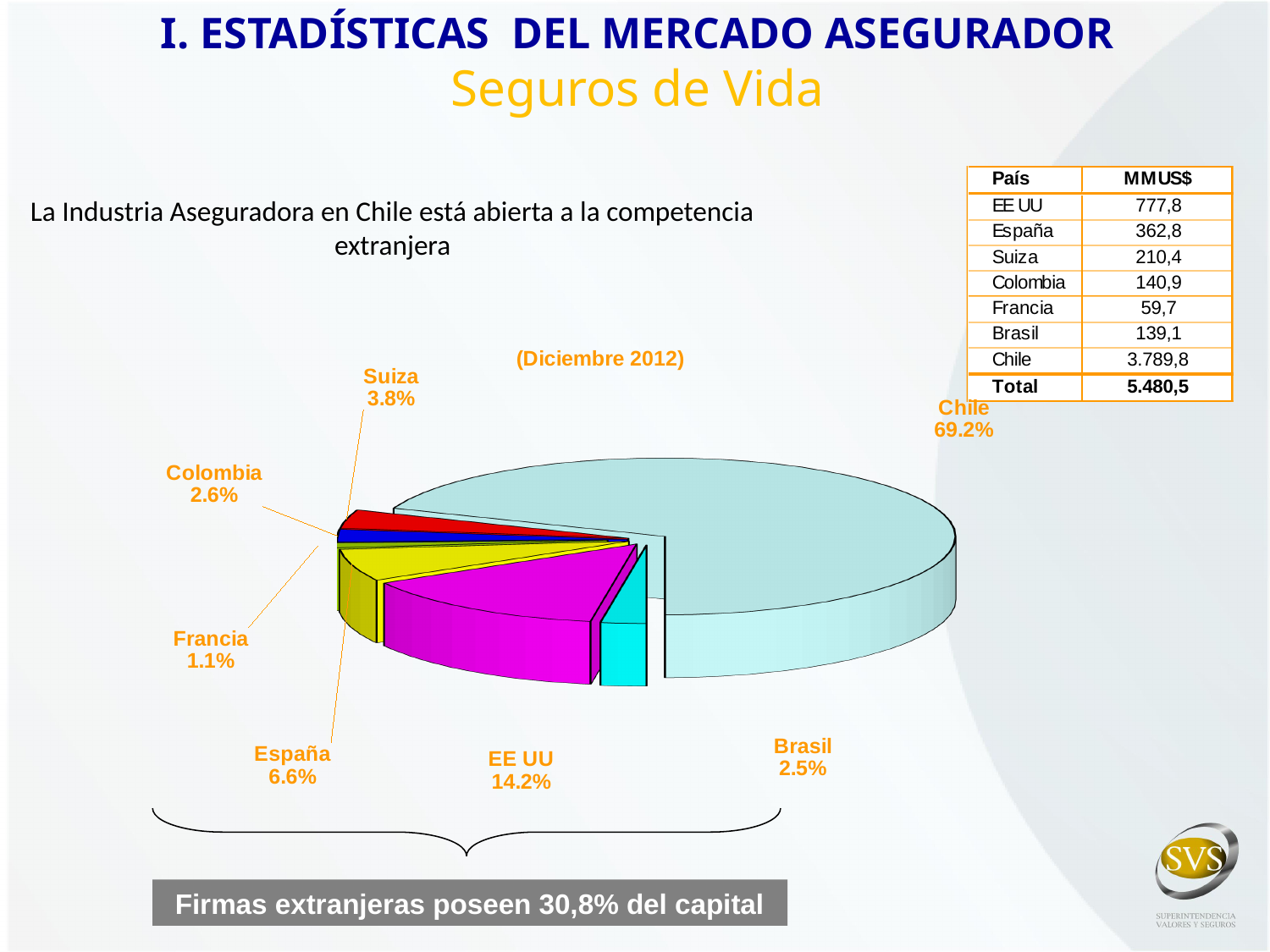
Which country has the smallest slice of the pie chart? Francia Which country has the largest slice of the pie chart? Chile What is the difference in percentage points between the EE UU slice and the España slice? 7.6 What percentage is shown for España in the pie chart? 6.6% What kind of chart is shown on the slide? pie chart Which has a larger share in the pie chart, Colombia or Brasil? Colombia What percentage is shown for Suiza in the pie chart? 3.8% What share of the pie chart does Chile hold? 69.2% What is the difference in percentage points between the Chile slice and the EE UU slice? 55.0 What percentage is shown for EE UU in the pie chart? 14.2% What date is given in the title above the pie chart? Diciembre 2012 How many slices (countries) does the pie chart show? 7